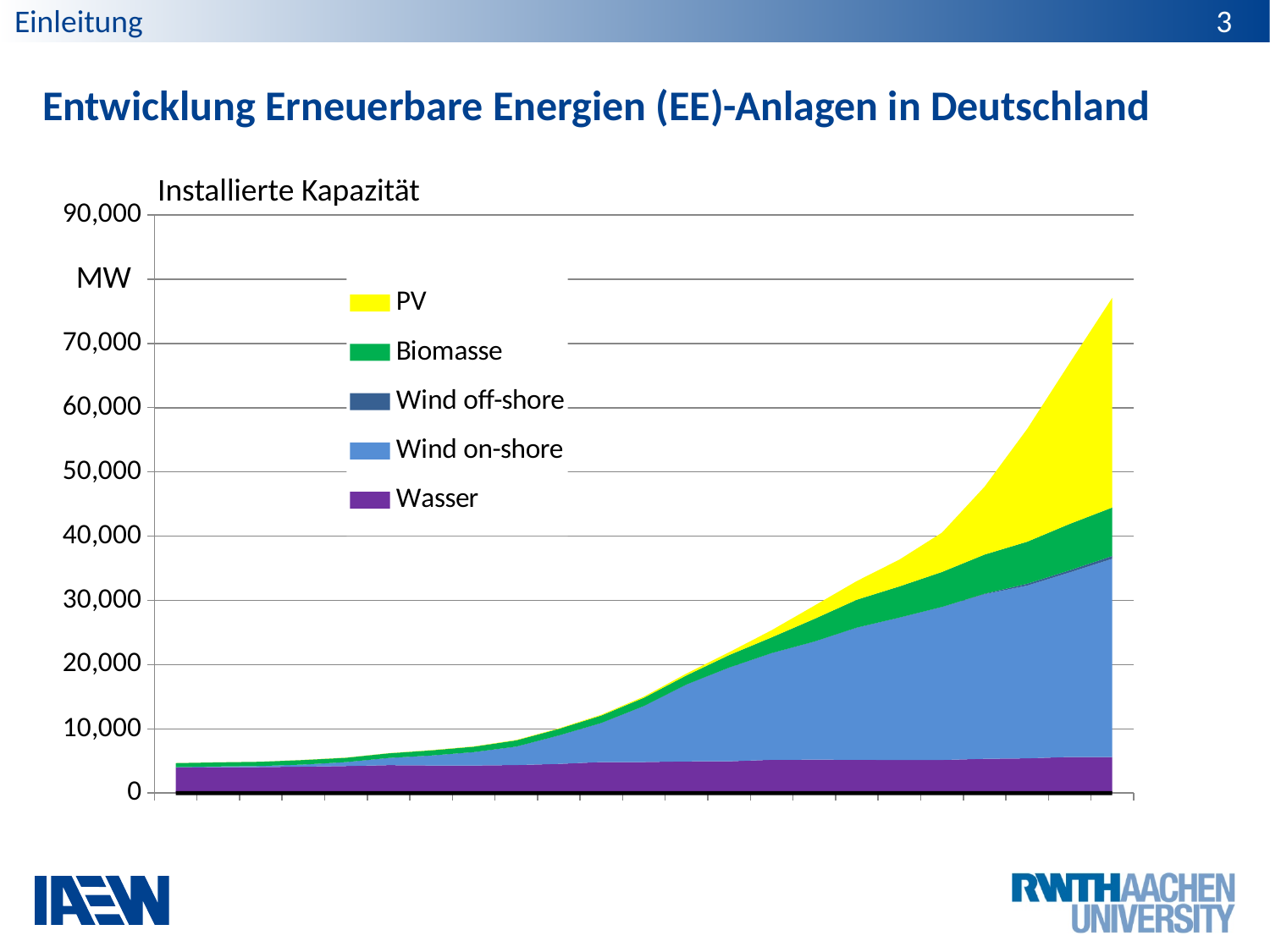
Does the total installed capacity rise or fall along the x axis? rise At the right end of the chart, which is larger, Wind on-shore or Wasser? Wind on-shore Is the Wasser value at the right end of the chart greater or less than 10,000? less What kind of chart is shown on the slide? stacked area chart What unit is shown on the y axis of the chart? MW What is the title of the chart? Installierte Kapazität Is the total installed capacity at the left end of the chart greater or less than 10,000? less What is the highest value shown on the y axis of the chart? 90,000 Which series has the smallest area at the right end of the chart? Wind off-shore Is the total installed capacity at the right end of the chart greater or less than 70,000? greater How many series does the legend of the chart list? 5